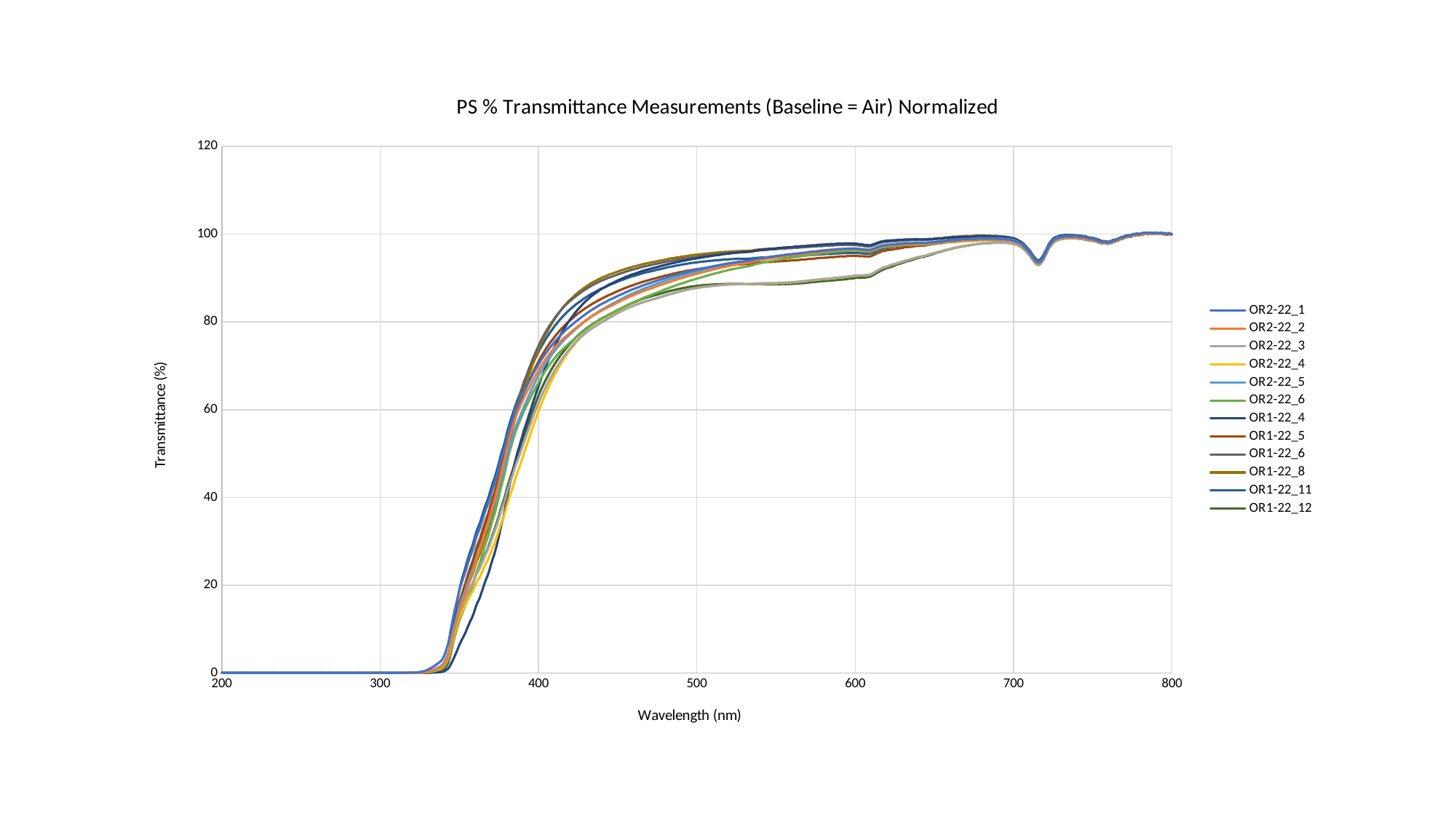
At 300 nm, is the value for OR2-22_1 greater or less than 20? less What is the label of the y axis? Transmittance (%) At 400 nm, is the value for OR2-22_4 greater or less than 40? greater Do the transmittance values overall rise or fall as wavelength increases from 200 nm to 800 nm? rise At 800 nm, is the value for OR1-22_8 greater or less than 80? greater What is the title of the chart? PS % Transmittance Measurements (Baseline = Air) Normalized How many series does the legend list? 12 What kind of chart is shown on the slide? line chart